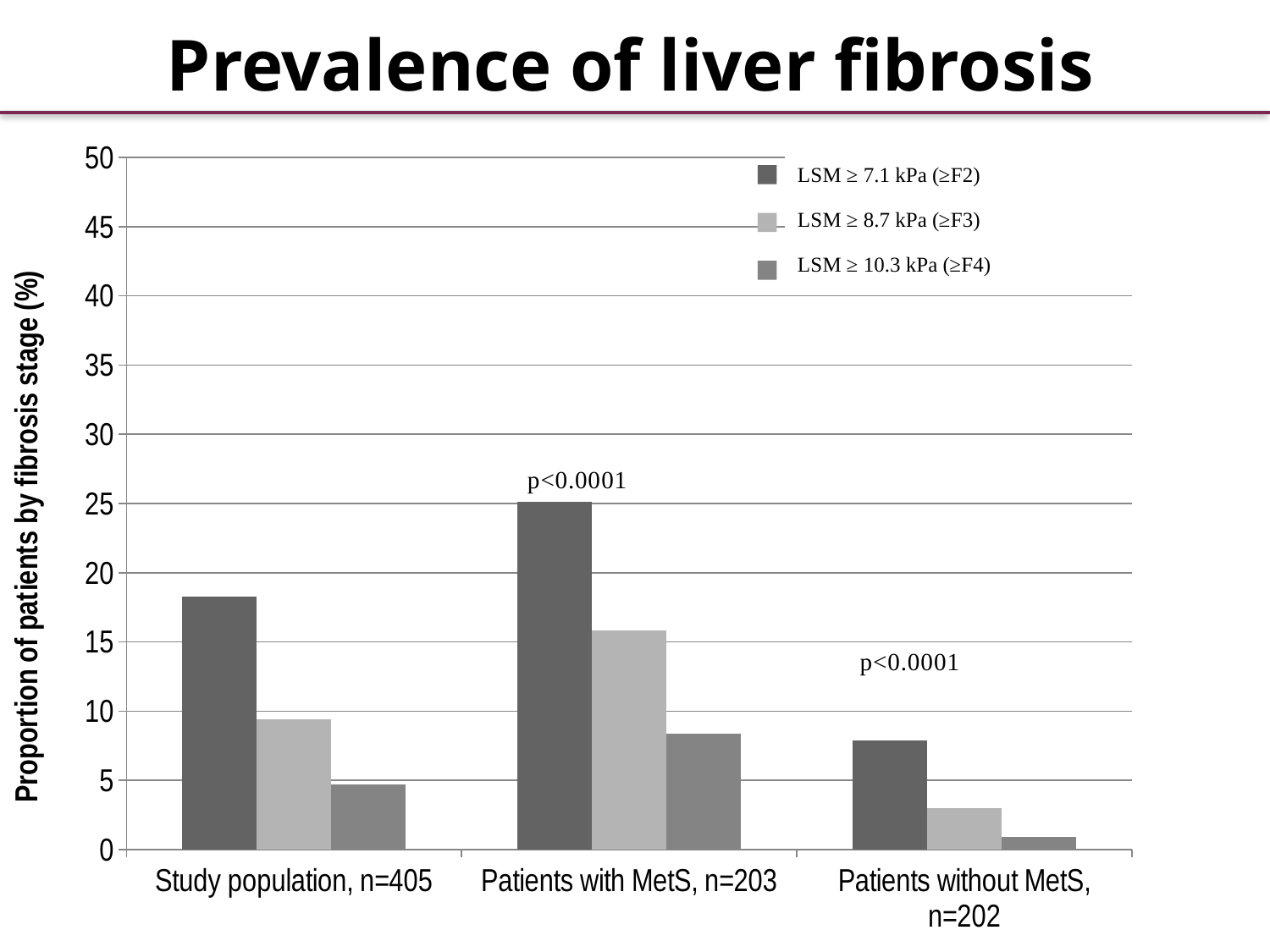
What is the label of the y axis? Proportion of patients by fibrosis stage (%) Which category has the lowest value for LSM ≥ 10.3 kPa (≥F4)? Patients without MetS, n=202 How many series does the legend list? 3 Which category has the highest value for LSM ≥ 7.1 kPa (≥F2)? Patients with MetS, n=203 What type of chart is shown on the slide? bar chart Is the value for LSM ≥ 7.1 kPa (≥F2) in Patients with MetS, n=203 greater or less than 20? greater Is the value for LSM ≥ 7.1 kPa (≥F2) in Patients without MetS, n=202 greater or less than 10? less Is the value for LSM ≥ 7.1 kPa (≥F2) in the Study population, n=405 greater or less than 15? greater Within each category, do the bars rise or fall going from LSM ≥ 7.1 kPa (≥F2) to LSM ≥ 10.3 kPa (≥F4)? fall What is the title of the chart? Prevalence of liver fibrosis How many categories are shown on the x axis? 3 Which is larger: the LSM ≥ 8.7 kPa (≥F3) value for Patients with MetS, n=203 or for Patients without MetS, n=202? Patients with MetS, n=203